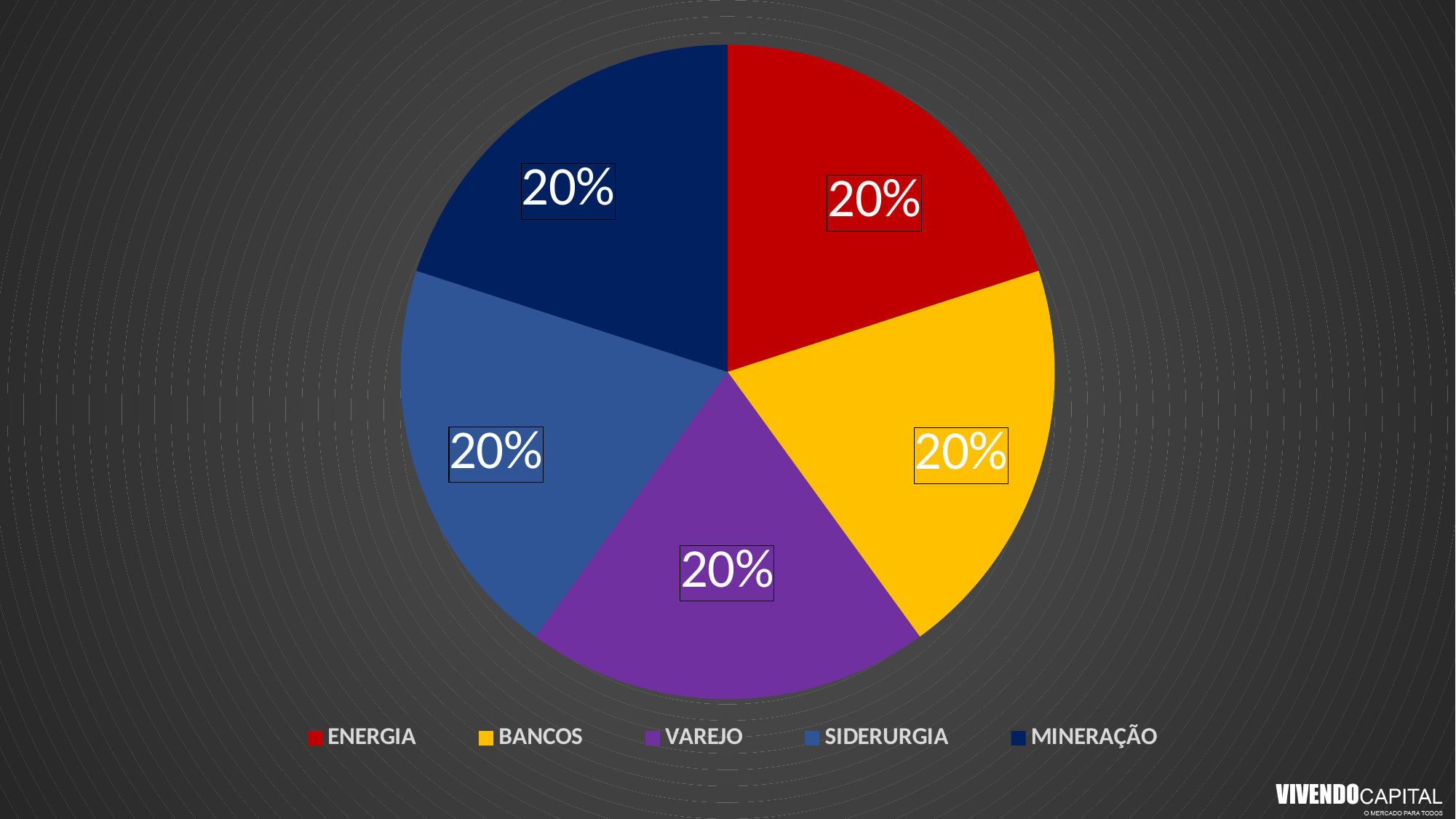
What share of the pie does ENERGIA represent? 20% What is the combined share of BANCOS and SIDERURGIA? 40% How many slices does the pie chart have? 5 What is the difference between the shares of ENERGIA and VAREJO? 0% Which colour represents MINERAÇÃO in the pie chart? dark blue What share of the pie does BANCOS represent? 20% What kind of chart is shown on the slide? pie chart What share of the pie does VAREJO represent? 20% Which category is shown in yellow in the pie chart? BANCOS How many entries does the legend list? 5